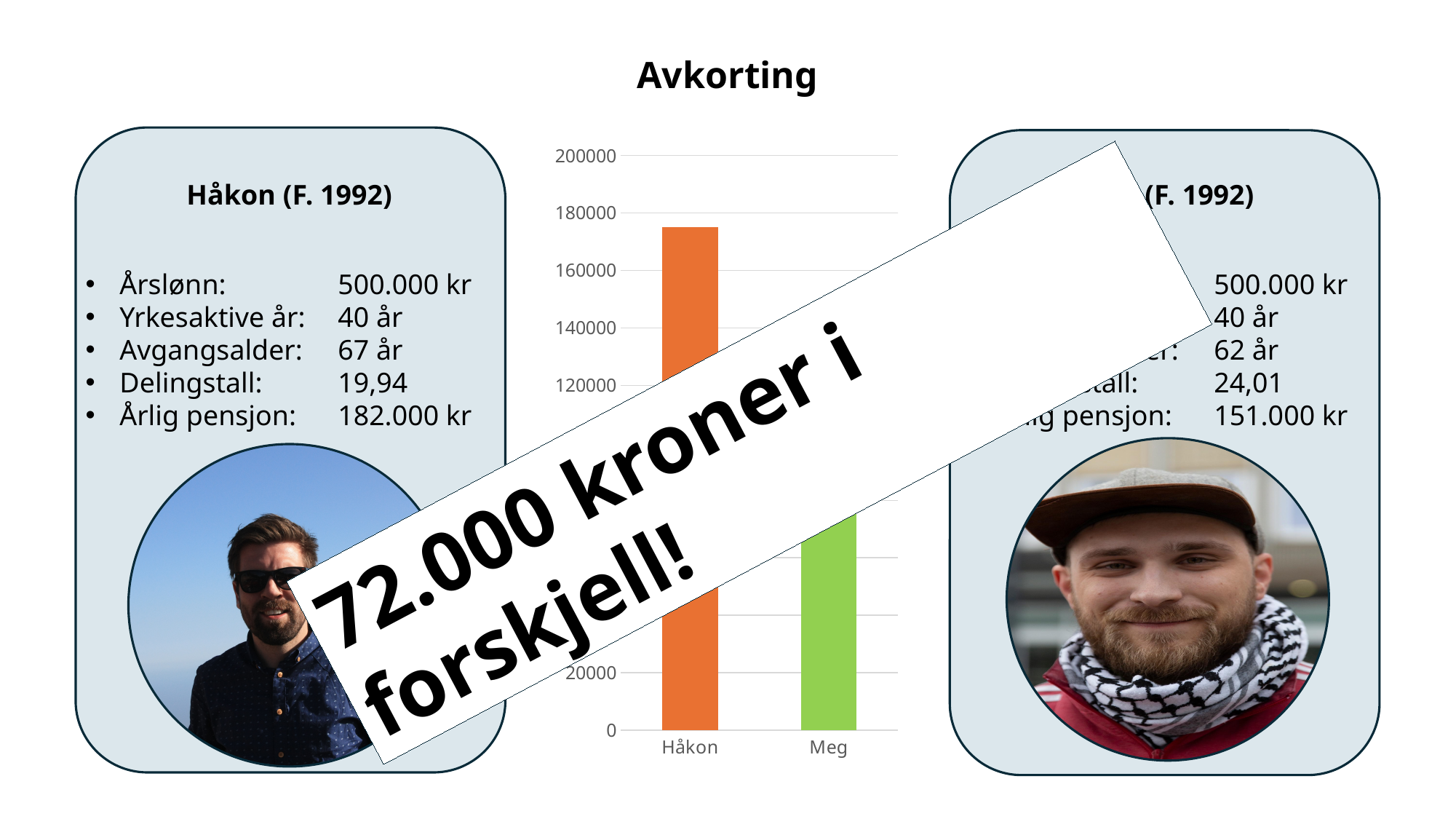
Is the value for Håkon greater or less than 180000? less What is the highest value shown on the y axis of the chart? 200000 Which bar is taller, Håkon or Meg? Håkon Is the value for Håkon greater or less than 160000? greater Which category has the highest bar in the chart? Håkon Is the value for Meg greater or less than 60000? greater How many categories are plotted on the x axis of the chart? 2 What is the title of the chart? Avkorting What colour is the bar for Håkon? orange Which category has the lowest bar in the chart? Meg What kind of chart is shown on the slide? bar chart